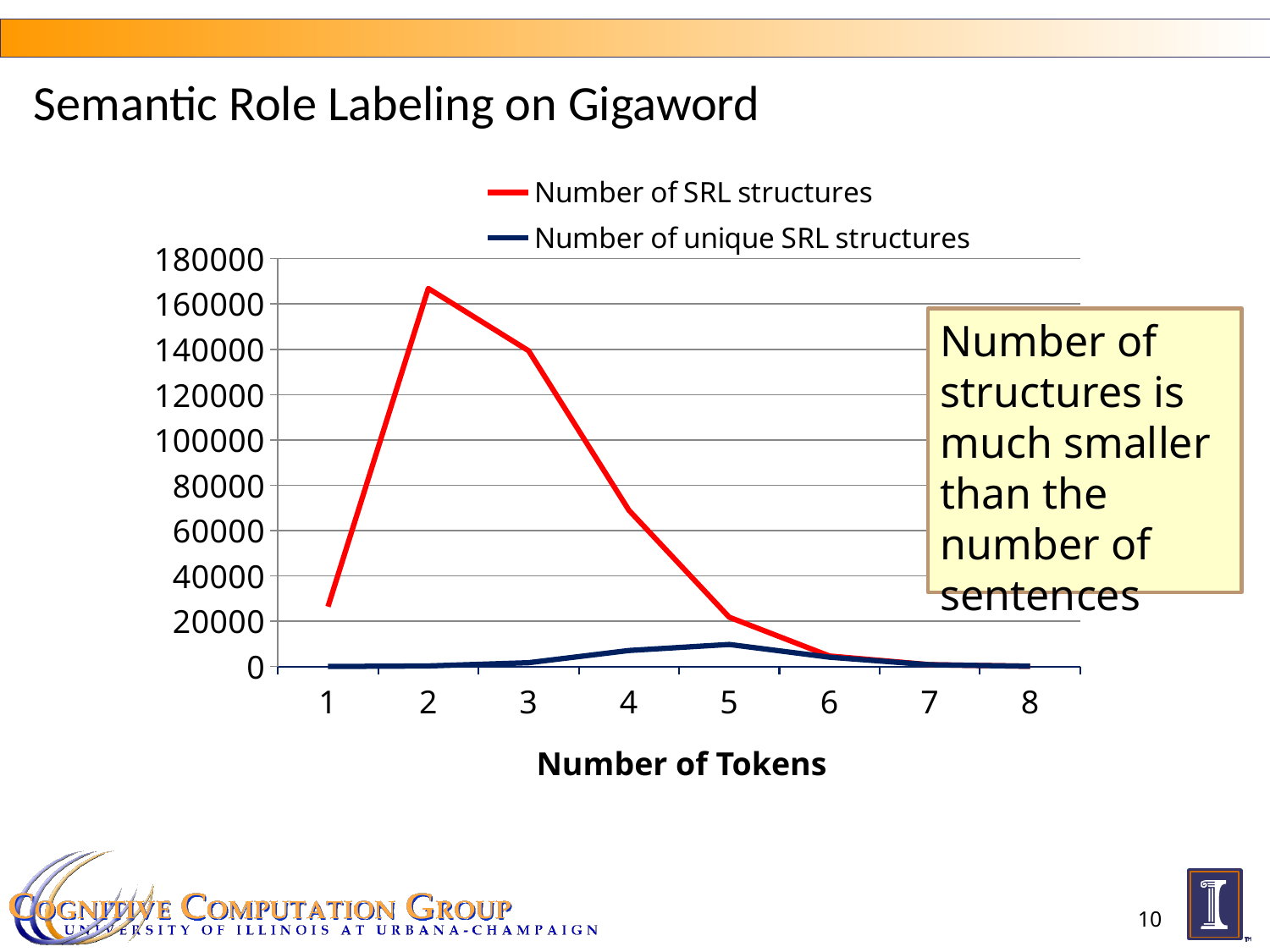
Is the value of Number of SRL structures at 1 token greater or less than 40000? less What kind of chart is shown on the slide? line chart Does the Number of SRL structures series rise or fall from 2 tokens to 8 tokens? fall How many points along the x axis (Number of Tokens) are plotted for each series? 8 At 3 tokens, which series has the larger value: Number of SRL structures or Number of unique SRL structures? Number of SRL structures Is the value of Number of SRL structures at 4 tokens greater or less than 60000? greater At which number of tokens does the Number of SRL structures series reach its highest value? 2 What is the title of the x axis? Number of Tokens Which colour is used for the Number of unique SRL structures series? dark blue How many series does the legend list? 2 Is the value of Number of unique SRL structures at 5 tokens greater or less than 20000? less